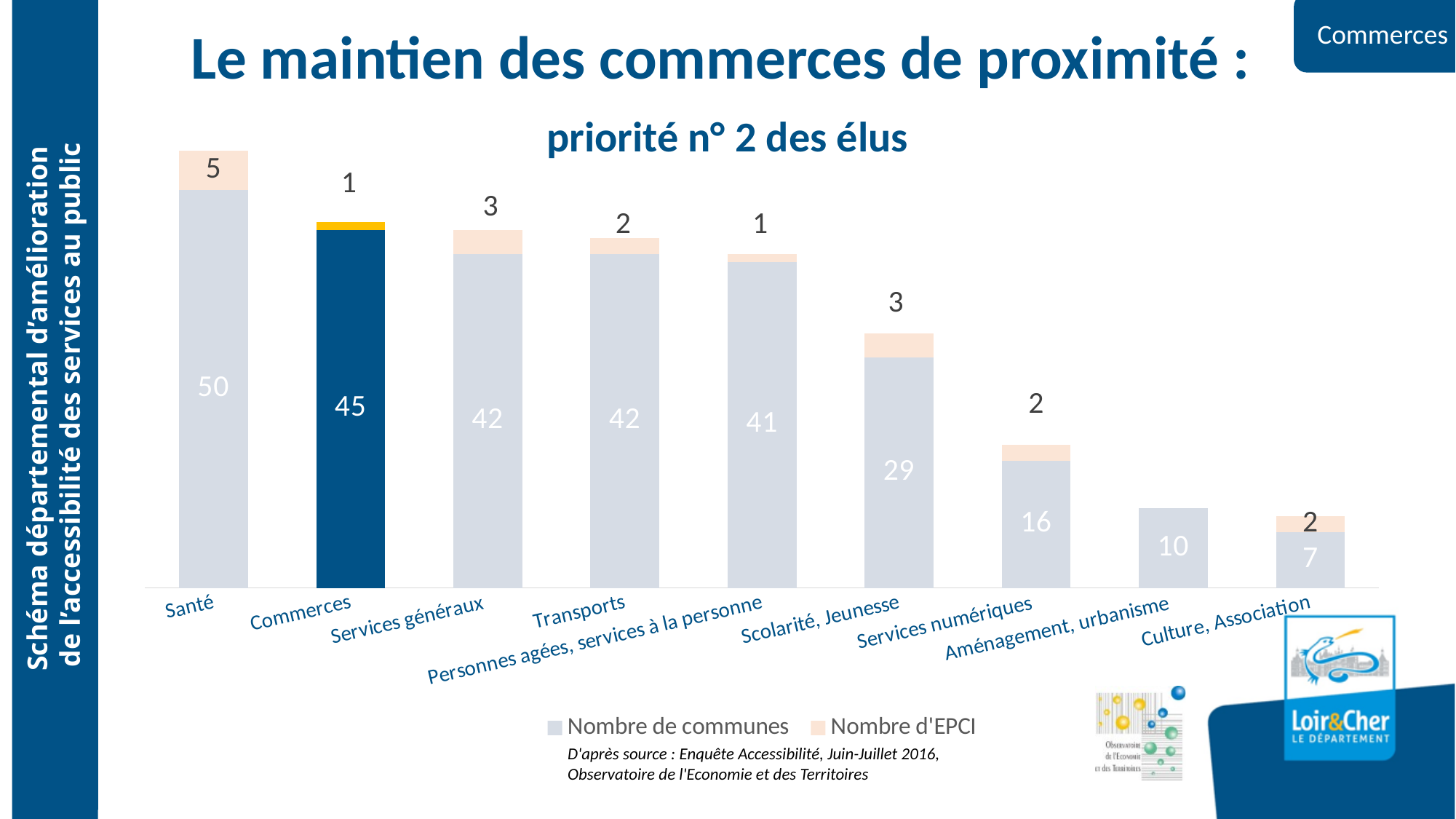
What is the Nombre de communes value for Scolarité, Jeunesse? 29 Which category has the lowest Nombre de communes? Culture, Association What is the total of the stacked bar for Commerces (communes plus EPCI)? 46 Which category's bar is highlighted in dark blue? Commerces Which category has the highest Nombre de communes? Santé What kind of chart is shown on the slide? Stacked bar chart How many series does the legend list? 2 What is the Nombre de communes value for Santé? 50 What is the difference in Nombre de communes between Santé and Commerces? 5 Which has a larger Nombre de communes, Services numériques or Aménagement, urbanisme? Services numériques What is the Nombre d'EPCI value for Services généraux? 3 How many categories are shown on the x axis? 9